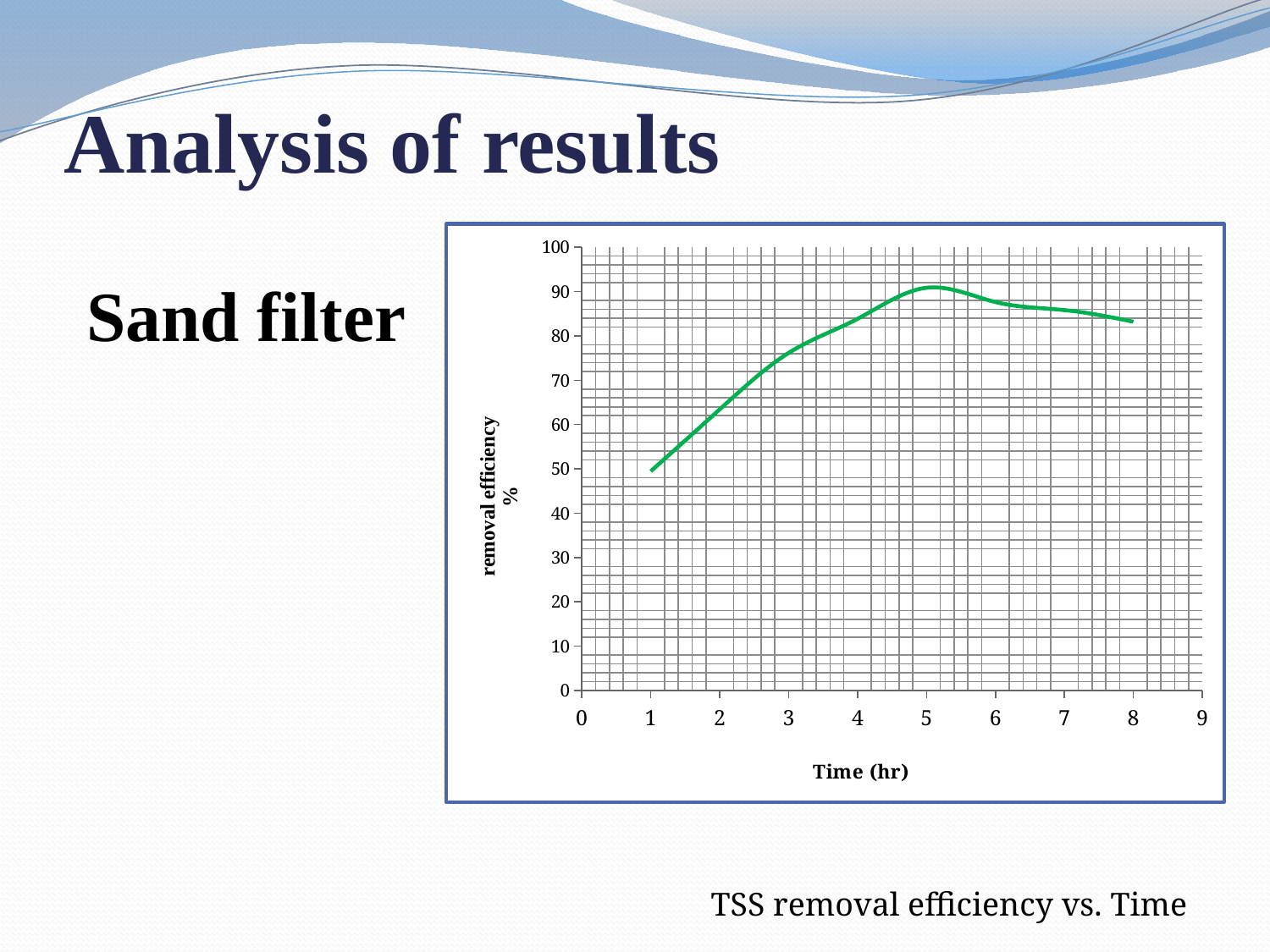
What is the label of the y axis of the chart? removal efficiency % Is the removal efficiency at 3 hr greater or less than 70? greater At which time (hr) does the removal efficiency reach its highest value? 5 What is the label of the x axis of the chart? Time (hr) Does the removal efficiency rise or fall between 5 hr and 8 hr? fall Is the removal efficiency at 8 hr greater or less than 90? less Is the removal efficiency at 5 hr greater or less than 80? greater At which time (hr) is the removal efficiency lowest? 1 What kind of chart is shown on the slide? line chart Does the removal efficiency rise or fall between 1 hr and 5 hr? rise Which is larger, the removal efficiency at 8 hr or at 3 hr? 8 hr